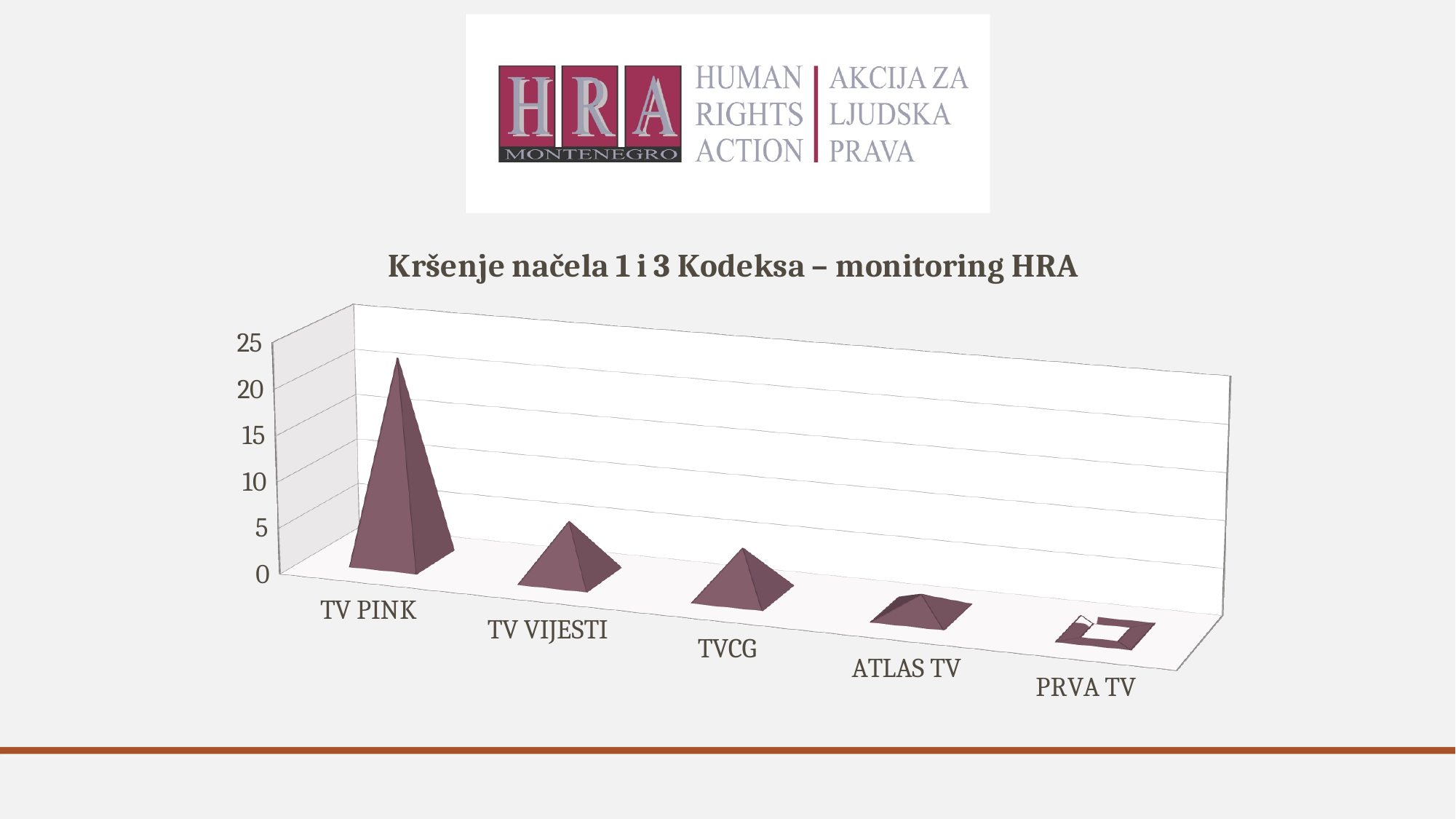
What is the title of the chart? Kršenje načela 1 i 3 Kodeksa – monitoring HRA Is the value for TV VIJESTI greater or less than 10? less Is the value for TV PINK greater or less than 20? greater Which TV station has the highest value on the chart? TV PINK Is the value for ATLAS TV greater or less than 5? less What kind of chart is shown on the slide? bar chart How many TV stations (categories) are shown on the chart? 5 Which TV station has the lowest value on the chart? PRVA TV Which has a larger value, TV PINK or TVCG? TV PINK Which has a larger value, TV VIJESTI or ATLAS TV? TV VIJESTI Do the values rise or fall moving from TV PINK to PRVA TV along the x axis? fall